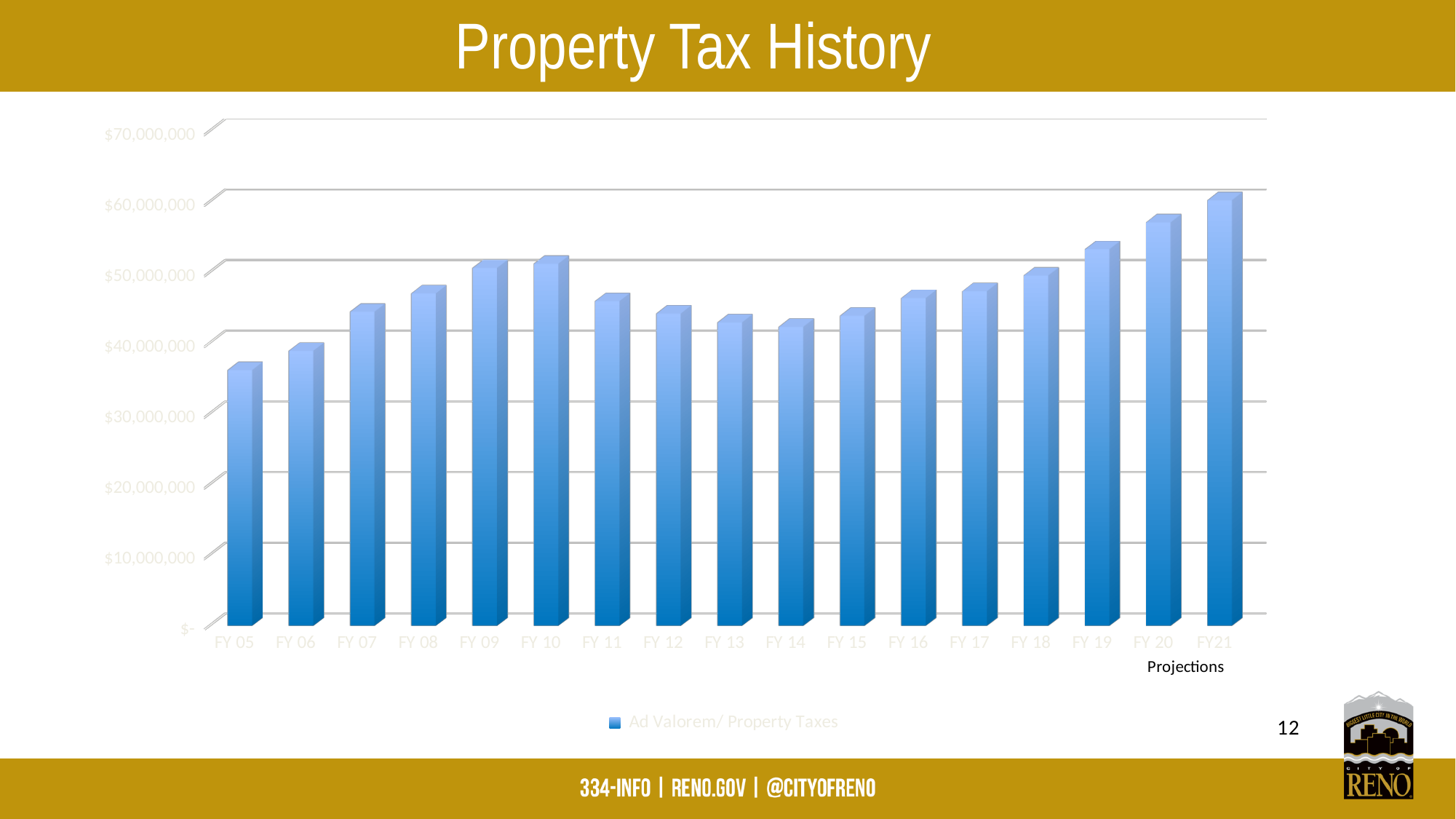
What kind of chart is shown on the slide? bar chart Is the value for FY 05 greater or less than $40,000,000? less How many series does the legend list? 1 Which fiscal year has the highest property tax value? FY21 Is the value for FY 20 greater or less than $50,000,000? greater Which is larger, the value for FY 10 or the value for FY 14? FY 10 Is the value for FY 13 greater or less than $50,000,000? less How many fiscal years are plotted on the x axis? 17 Do the values rise or fall from FY 14 to FY21? rise What is the series name shown in the legend? Ad Valorem/ Property Taxes Which fiscal year has the lowest property tax value? FY 05